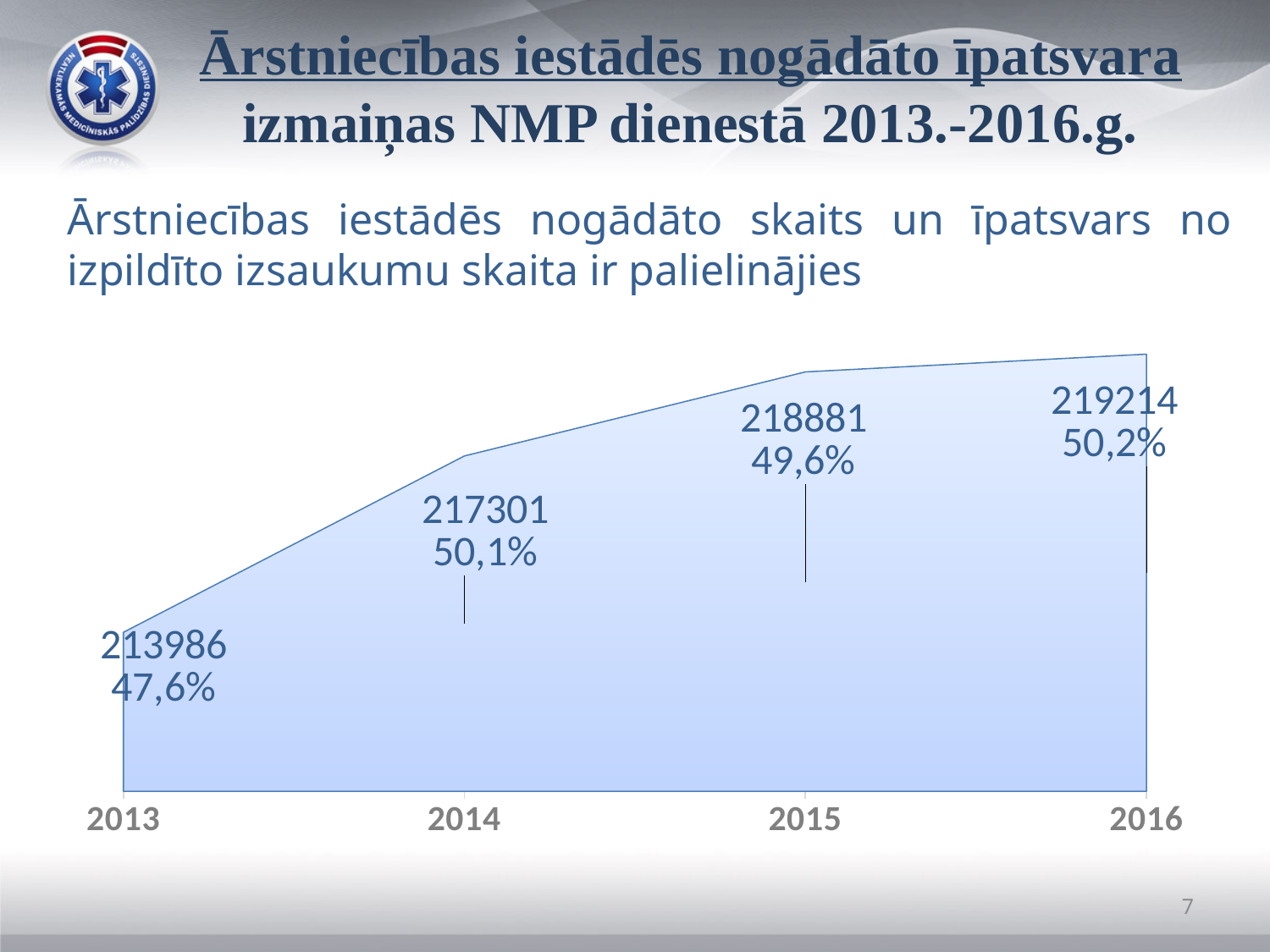
What is the difference between the 2016 value and the 2013 value? 5228 What percentage is shown for 2016? 50,2% What percentage is shown for 2014? 50,1% What is the difference between the 2015 value and the 2014 value? 1580 Which year has the lowest number of patients delivered? 2013 How many years are shown on the x axis? 4 What kind of chart is shown on the slide? area chart Do the plotted values rise or fall from 2013 to 2016? rise Which year has the larger percentage, 2014 or 2015? 2014 Which year has the highest number of patients delivered? 2016 What is the number of patients delivered to medical institutions in 2013? 213986 What is the value shown for 2015? 218881